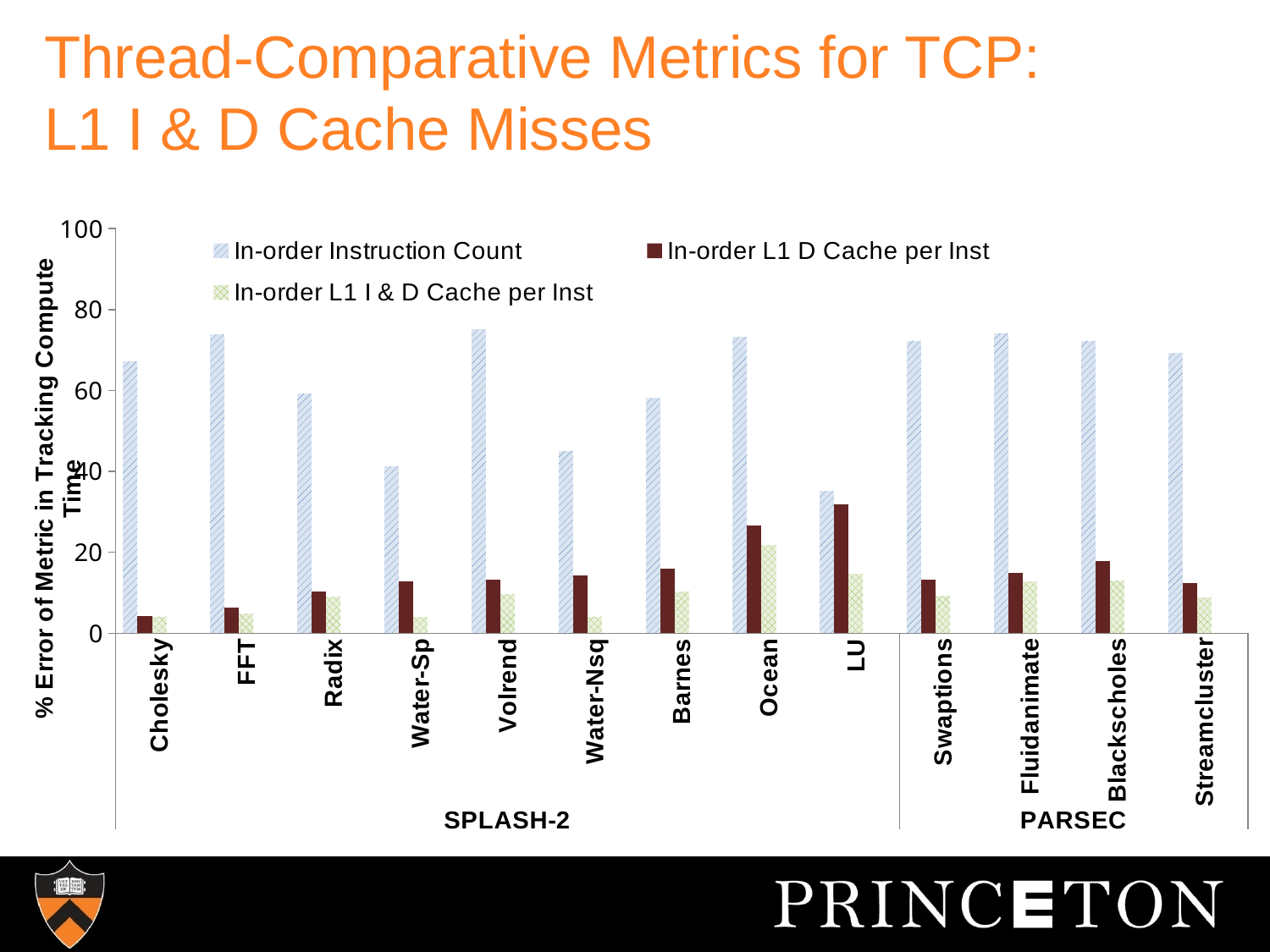
Which category has the lowest In-order Instruction Count value? LU Is the In-order Instruction Count value for LU greater or less than 40? less Which category has the highest In-order L1 I & D Cache per Inst value? Ocean How many benchmark categories are plotted along the x axis? 13 Which category has the highest In-order L1 D Cache per Inst value? LU What are the two benchmark suite groups labelled below the x axis? SPLASH-2 and PARSEC Which is larger, the In-order L1 D Cache per Inst value for Ocean or for LU? LU What kind of chart is shown on the slide? bar chart Is the In-order Instruction Count value for Cholesky greater or less than 60? greater Is the In-order L1 D Cache per Inst value for Ocean greater or less than 20? greater How many series does the legend list? 3 Which is larger, the In-order Instruction Count value for Cholesky or for FFT? FFT